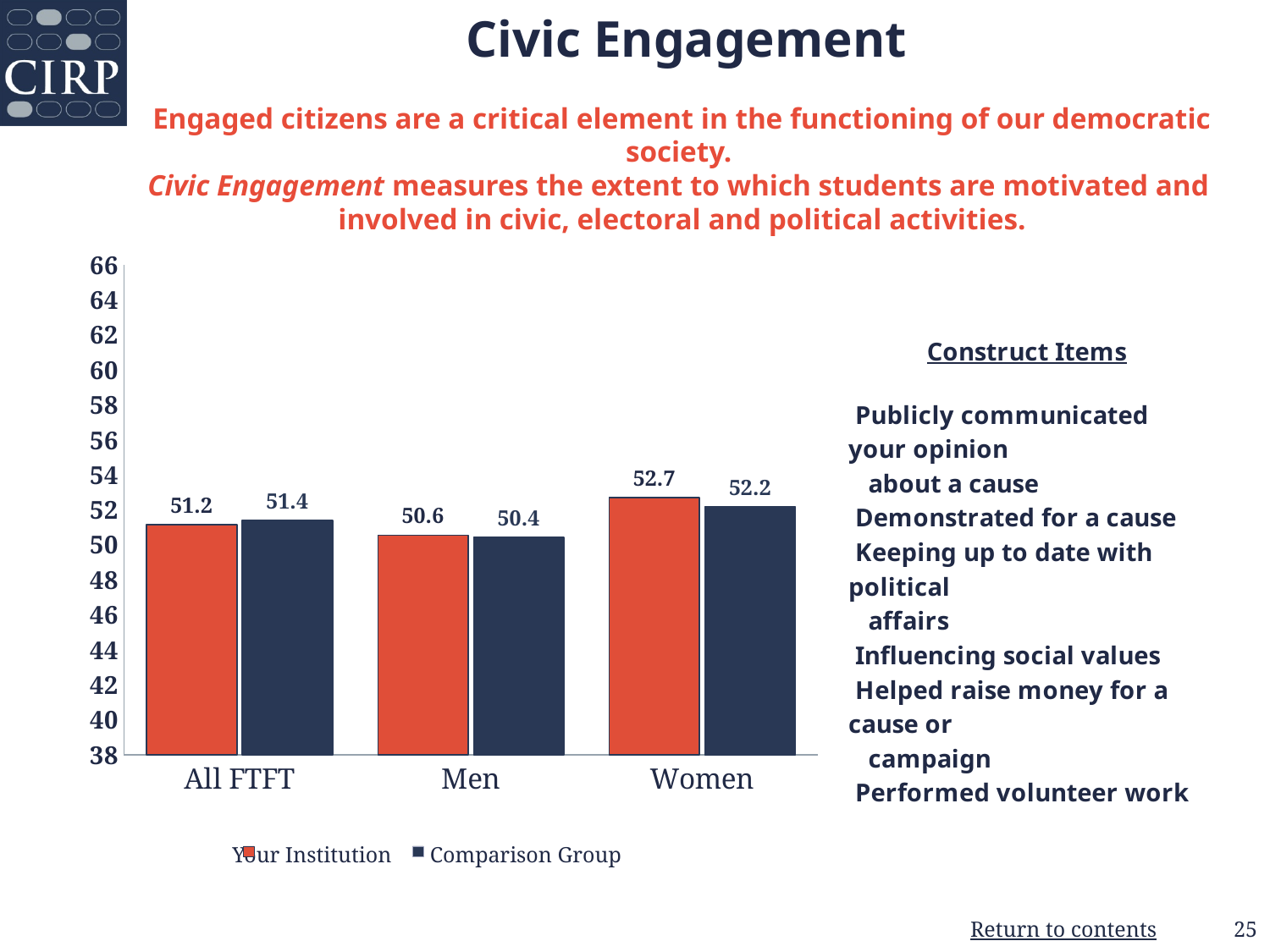
Is the value for Your Institution in the Women category greater or less than 50? greater How many series does the legend list? 2 How many categories are shown on the x axis? 3 What is the value for the Comparison Group in the Women category? 52.2 What is the title of the slide containing the chart? Civic Engagement What is the value for Your Institution in the Men category? 50.6 What is the value for Your Institution in the All FTFT category? 51.2 In the Men category, which is larger: Your Institution or the Comparison Group? Your Institution Which category has the highest value for Your Institution? Women Which category has the lowest value for the Comparison Group? Men What is the difference between Your Institution and the Comparison Group in the Women category? 0.5 What kind of chart is shown on the slide? bar chart